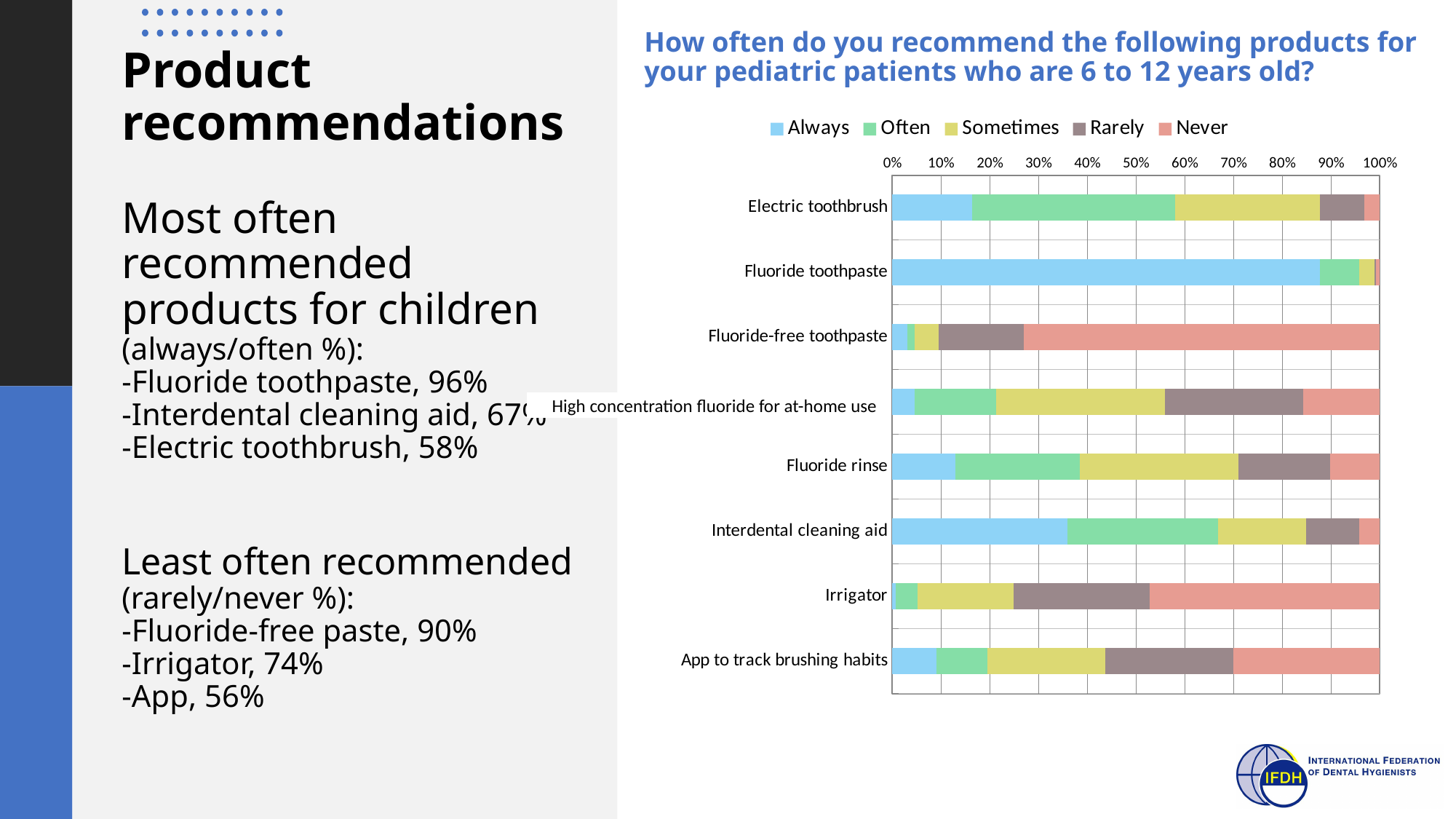
Which product has the smallest 'Always' share? Irrigator Which product has the largest 'Never' share? Fluoride-free toothpaste Which legend entry is listed first in the chart legend? Always What kind of chart is shown on the slide? Stacked bar chart How many products are listed on the chart? 8 Is the 'Never' share for Irrigator greater or less than 40%? greater Is the 'Always' share for Fluoride toothpaste greater or less than 80%? greater Is the 'Never' share for Fluoride-free toothpaste greater or less than 60%? greater How many series does the chart legend list? 5 Which has the larger 'Often' share: Electric toothbrush or Interdental cleaning aid? Electric toothbrush Which product has the largest 'Always' share? Fluoride toothpaste